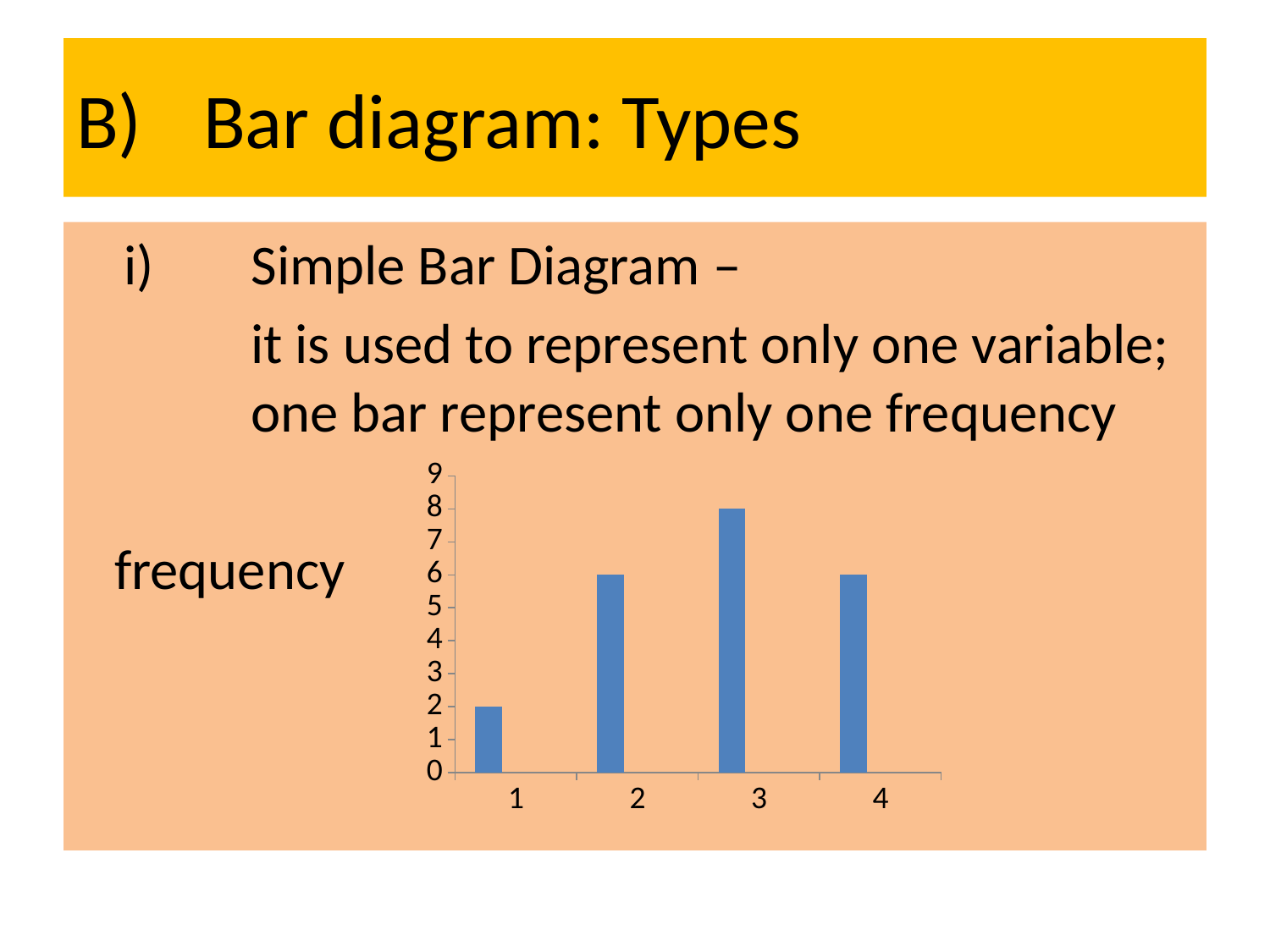
Is the value for category 4 greater or less than 5? greater How many bars are plotted in the chart? 4 What is the frequency for category 2? 6 What is the frequency for category 3? 8 What is the difference between the frequency for category 3 and the frequency for category 1? 6 Which category has the highest frequency? 3 Which has a larger frequency, category 2 or category 3? 3 What label is written to the left of the chart to describe the vertical axis? frequency What type of chart is shown on the slide? bar chart Which category has the lowest frequency? 1 What is the highest value shown on the vertical axis? 9 What is the frequency for category 1? 2